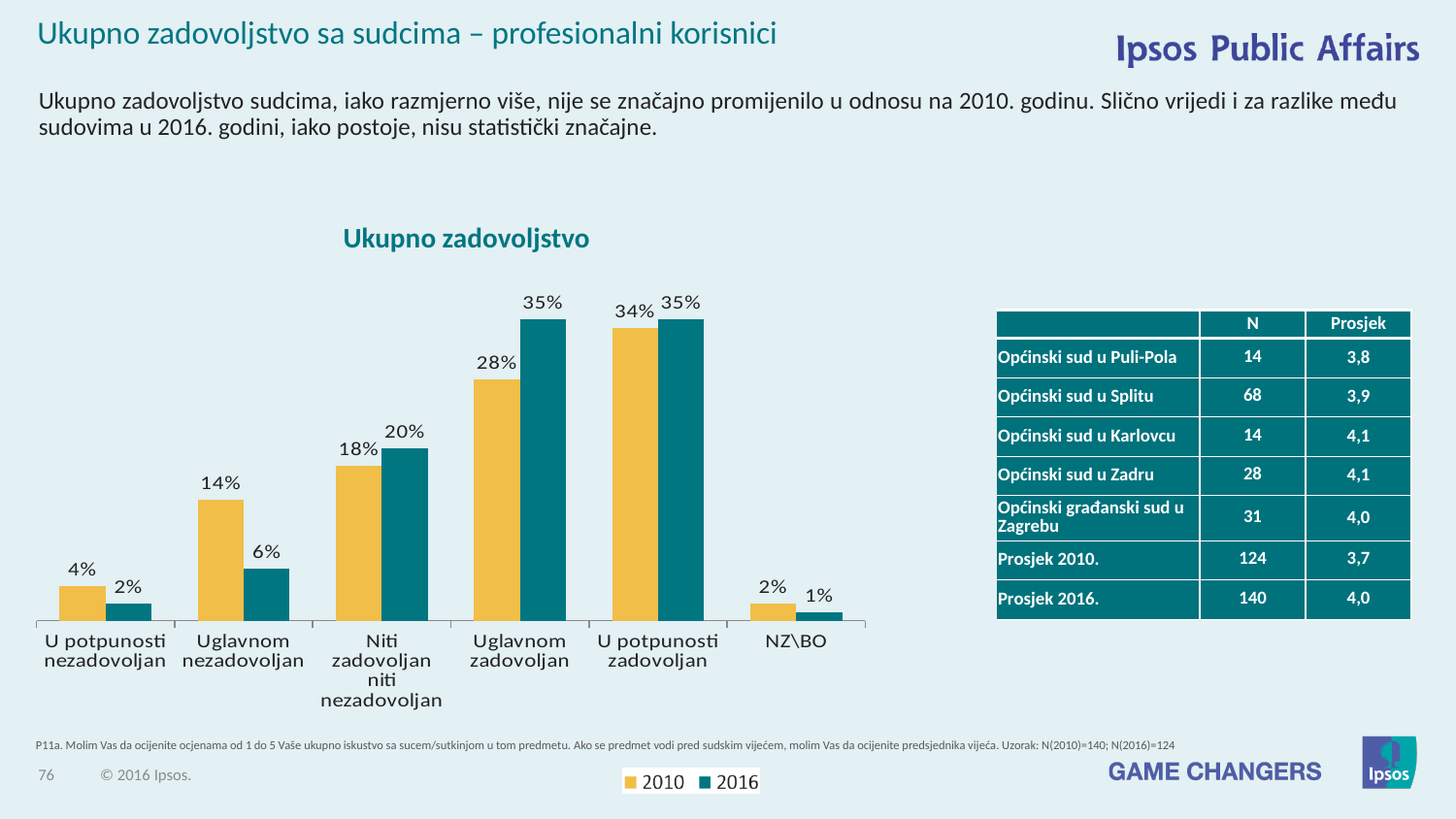
What type of chart is shown under the title "Ukupno zadovoljstvo"? bar chart What is the 2010 value for "Uglavnom nezadovoljan"? 14% Which is larger for "Uglavnom zadovoljan": the 2010 value or the 2016 value? 2016 How many categories are shown on the x axis of the "Ukupno zadovoljstvo" chart? 6 What is the difference between the 2010 and 2016 values for "Uglavnom nezadovoljan"? 8% How many series does the legend of the "Ukupno zadovoljstvo" chart list? 2 Which colour represents the 2016 series in the legend? teal Which category has the highest 2010 value? U potpunosti zadovoljan What is the difference between the 2016 values for "Uglavnom zadovoljan" and "Niti zadovoljan niti nezadovoljan"? 15% What is the 2016 value for "Niti zadovoljan niti nezadovoljan"? 20% Which category has the lowest 2016 value? NZ\BO What is the 2016 value for "Uglavnom zadovoljan"? 35%